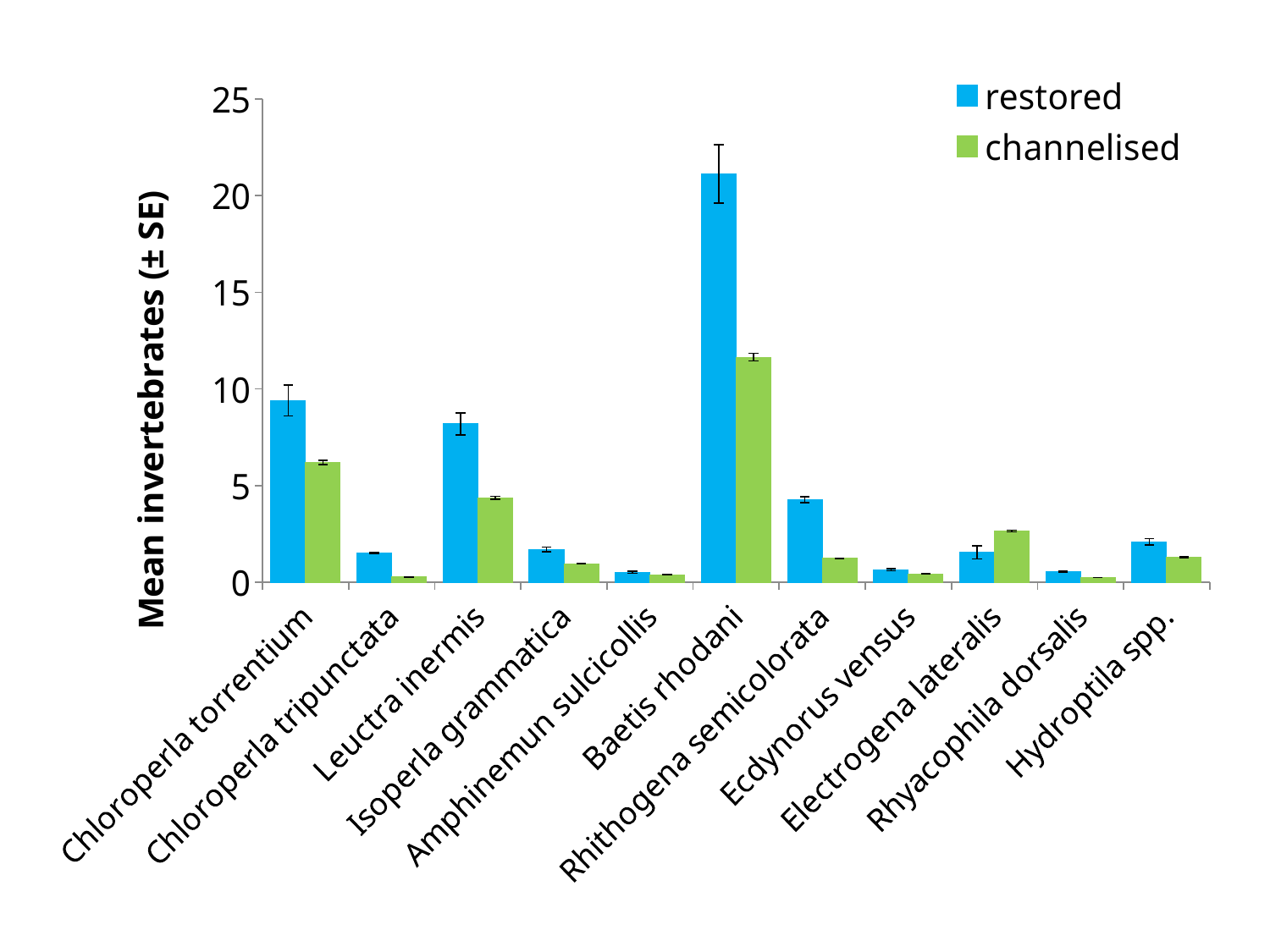
How many series does the legend list? 2 How many species categories are shown on the x axis? 11 Is the restored value for Rhithogena semicolorata greater or less than 5? less Is the channelised value for Baetis rhodani greater or less than 10? greater For Electrogena lateralis, which is larger: the restored value or the channelised value? channelised Which is larger: the restored value for Chloroperla torrentium or the restored value for Leuctra inermis? Chloroperla torrentium What is the label on the y axis? Mean invertebrates (± SE) Which species has the highest channelised value? Baetis rhodani What kind of chart is shown on the slide? bar chart Is the restored value for Leuctra inermis greater or less than 5? greater Which species has the highest restored value? Baetis rhodani